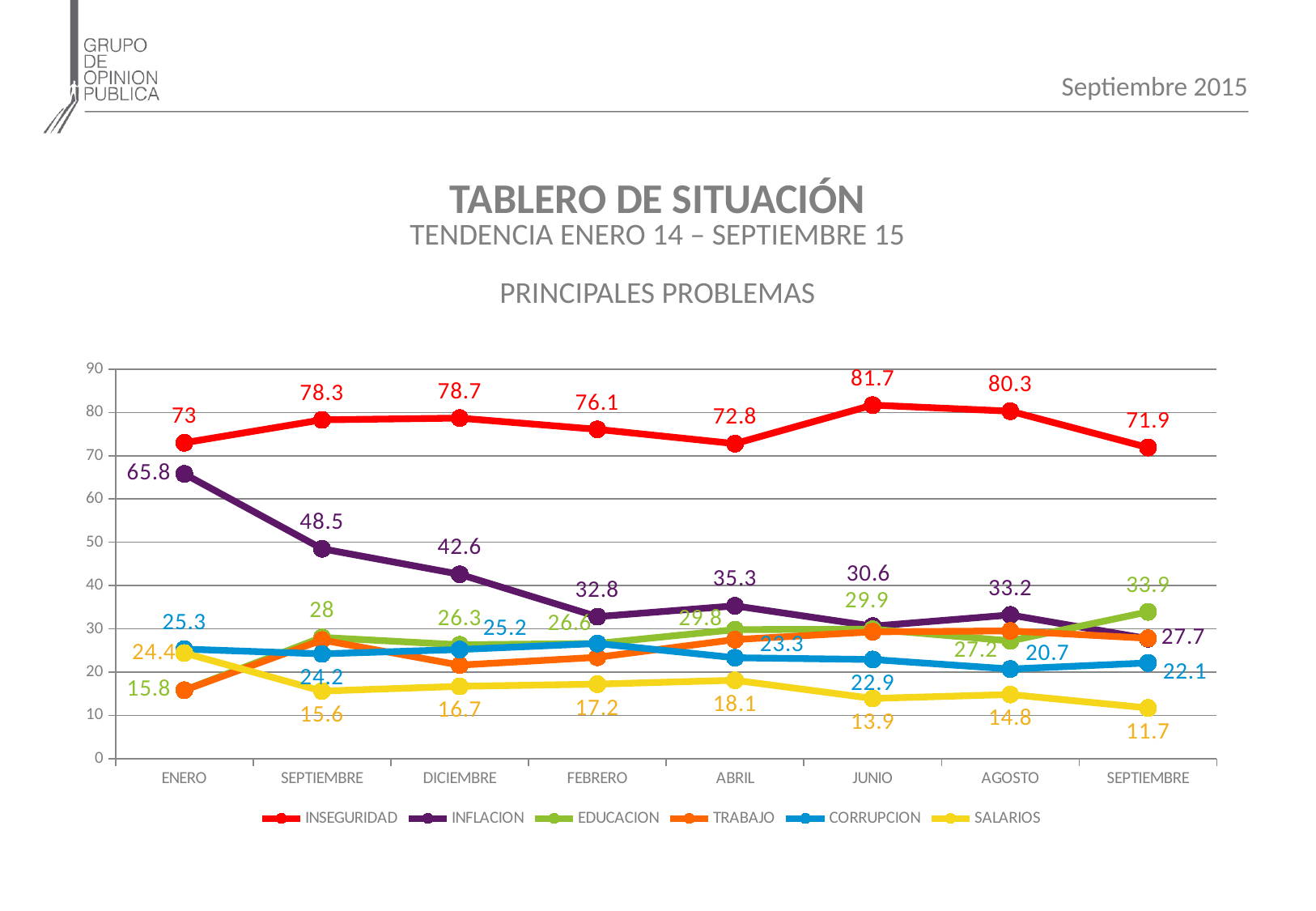
Is the value for TRABAJO in DICIEMBRE greater or less than 30? less What is the value for CORRUPCION in AGOSTO? 20.7 What is the difference between the INSEGURIDAD value in JUNIO and its value at the final SEPTIEMBRE point? 9.8 Which is larger in ENERO, INSEGURIDAD or INFLACION? INSEGURIDAD Does the INFLACION line generally rise or fall from ENERO to the final SEPTIEMBRE? fall What type of chart is shown on the slide? line chart What is the value for INSEGURIDAD in JUNIO? 81.7 In which month does INSEGURIDAD reach its highest value? JUNIO How many series does the legend list? 6 How many points are on the x axis of the chart? 8 What is the value for INFLACION in ENERO? 65.8 What is the lowest value shown for SALARIOS? 11.7